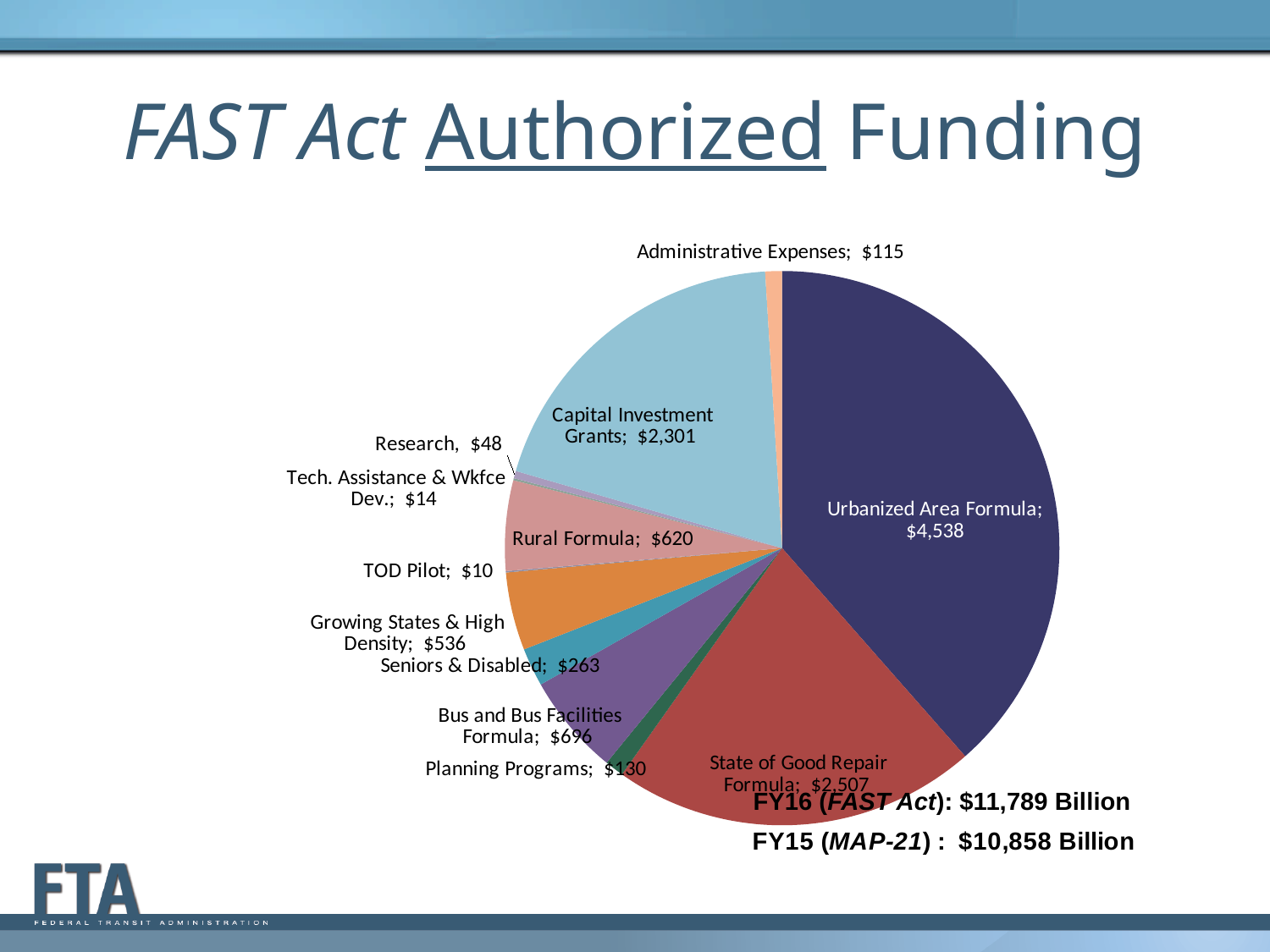
What is the difference between Urbanized Area Formula and State of Good Repair Formula? $2,031 What is the title of the slide containing the pie chart? FAST Act Authorized Funding What is the value for Urbanized Area Formula? $4,538 Which category has the largest slice of the pie? Urbanized Area Formula What is the value for Administrative Expenses? $115 What is the difference between Bus and Bus Facilities Formula and Seniors & Disabled? $433 What type of chart is shown on the slide? pie chart Which is larger, Capital Investment Grants or State of Good Repair Formula? State of Good Repair Formula What is the value for Capital Investment Grants? $2,301 Which category has the smallest value in the pie chart? TOD Pilot How many categories are shown in the pie chart? 12 What is the value for Rural Formula? $620